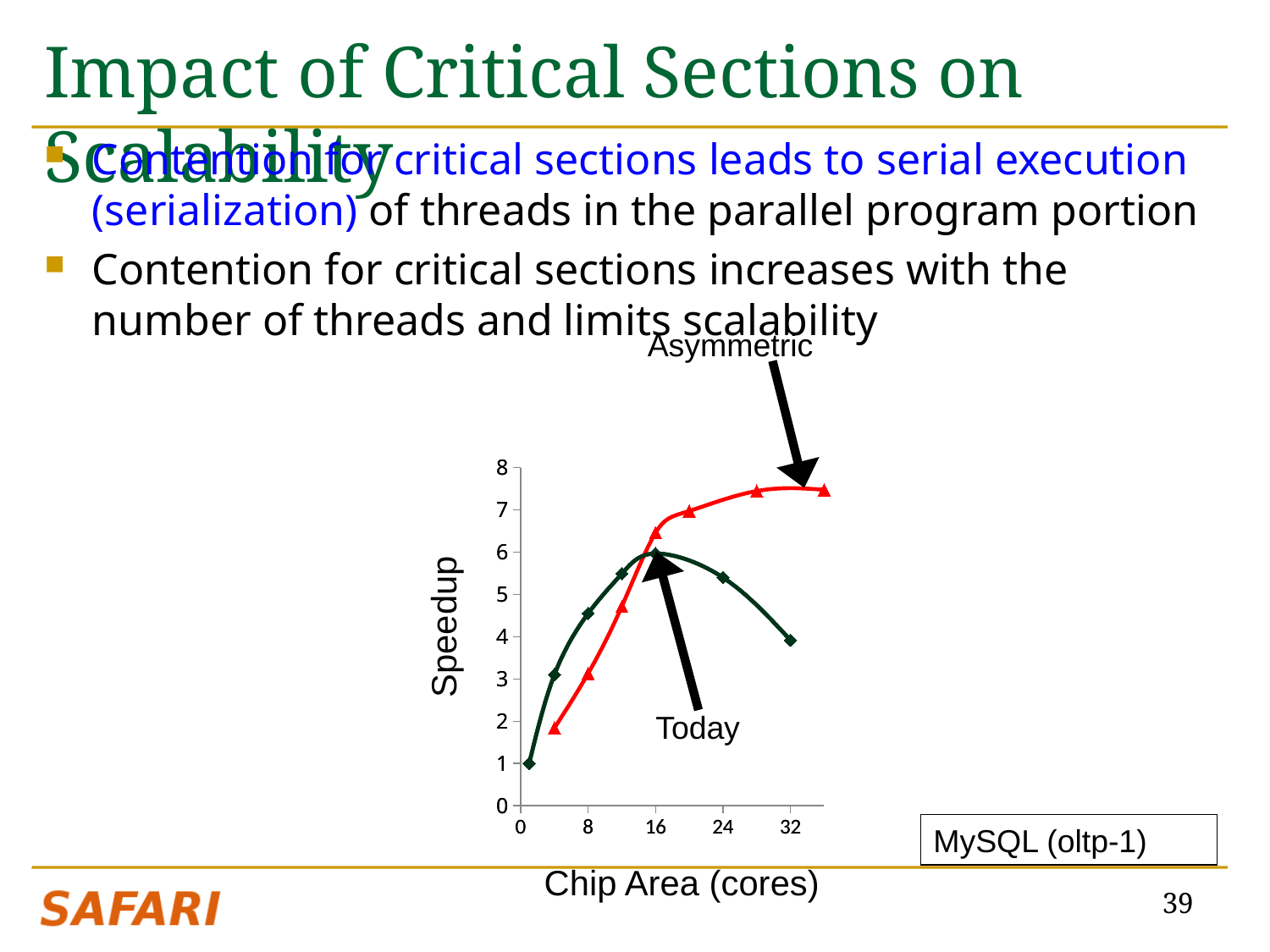
At 8 cores, which series has the higher speedup, the red (triangle) series or the green (diamond) series? green (diamond) series What is the speedup of the green (diamond) series at 0 cores? 1 Is the speedup of the red (triangle) series at 16 cores greater or less than 5? greater Is the speedup of the green (diamond) series at 8 cores greater or less than 4? greater What kind of chart is shown on the slide? line chart How many data series are plotted on the chart? 2 At what chip area (cores) does the green (diamond) series reach its highest speedup? 16 Does the speedup of the green (diamond) series keep rising as chip area increases, or does it rise and then fall? rises and then falls What is the label of the y axis of the chart? Speedup Is the speedup of the green (diamond) series at 32 cores greater or less than 5? less What is the label of the x axis of the chart? Chip Area (cores) At 32 cores, which series has the higher speedup, the red (triangle) series or the green (diamond) series? red (triangle) series